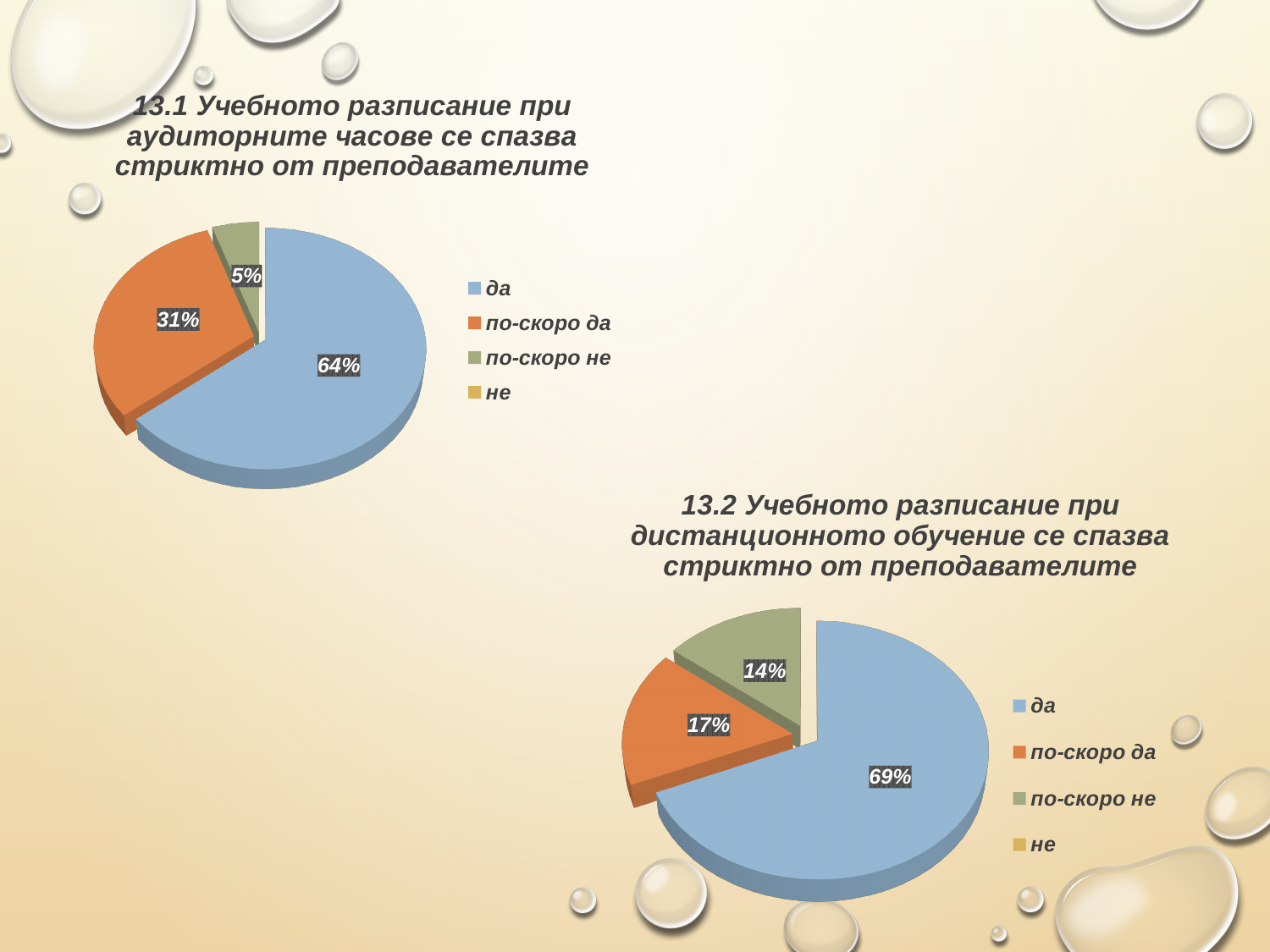
What kind of chart is the chart titled "13.2 Учебното разписание при дистанционното обучение се спазва стриктно от преподавателите"? pie chart In the chart titled "13.2 Учебното разписание при дистанционното обучение се спазва стриктно от преподавателите", what is the difference between "по-скоро да" and "по-скоро не"? 3% In the chart titled "13.1 Учебното разписание при аудиторните часове се спазва стриктно от преподавателите", which category has the largest slice? да In the chart titled "13.1 Учебното разписание при аудиторните часове се спазва стриктно от преподавателите", what is the difference between "да" and "по-скоро да"? 33% In the chart titled "13.2 Учебното разписание при дистанционното обучение се спазва стриктно от преподавателите", what share of the pie is "да"? 69% In the chart titled "13.2 Учебното разписание при дистанционното обучение се спазва стриктно от преподавателите", what colour is the "да" slice? blue In the chart titled "13.1 Учебното разписание при аудиторните часове се спазва стриктно от преподавателите", what is the value for "по-скоро да"? 31% In the chart titled "13.1 Учебното разписание при аудиторните часове се спазва стриктно от преподавателите", what is the value for "по-скоро не"? 5% How many entries does the legend of the chart titled "13.1 Учебното разписание при аудиторните часове се спазва стриктно от преподавателите" list? 4 In the chart titled "13.2 Учебното разписание при дистанционното обучение се спазва стриктно от преподавателите", which is larger, "по-скоро да" or "по-скоро не"? по-скоро да In the chart titled "13.2 Учебното разписание при дистанционното обучение се спазва стриктно от преподавателите", what is the value for "по-скоро не"? 14% In the chart titled "13.1 Учебното разписание при аудиторните часове се спазва стриктно от преподавателите", what share of the pie is "да"? 64%